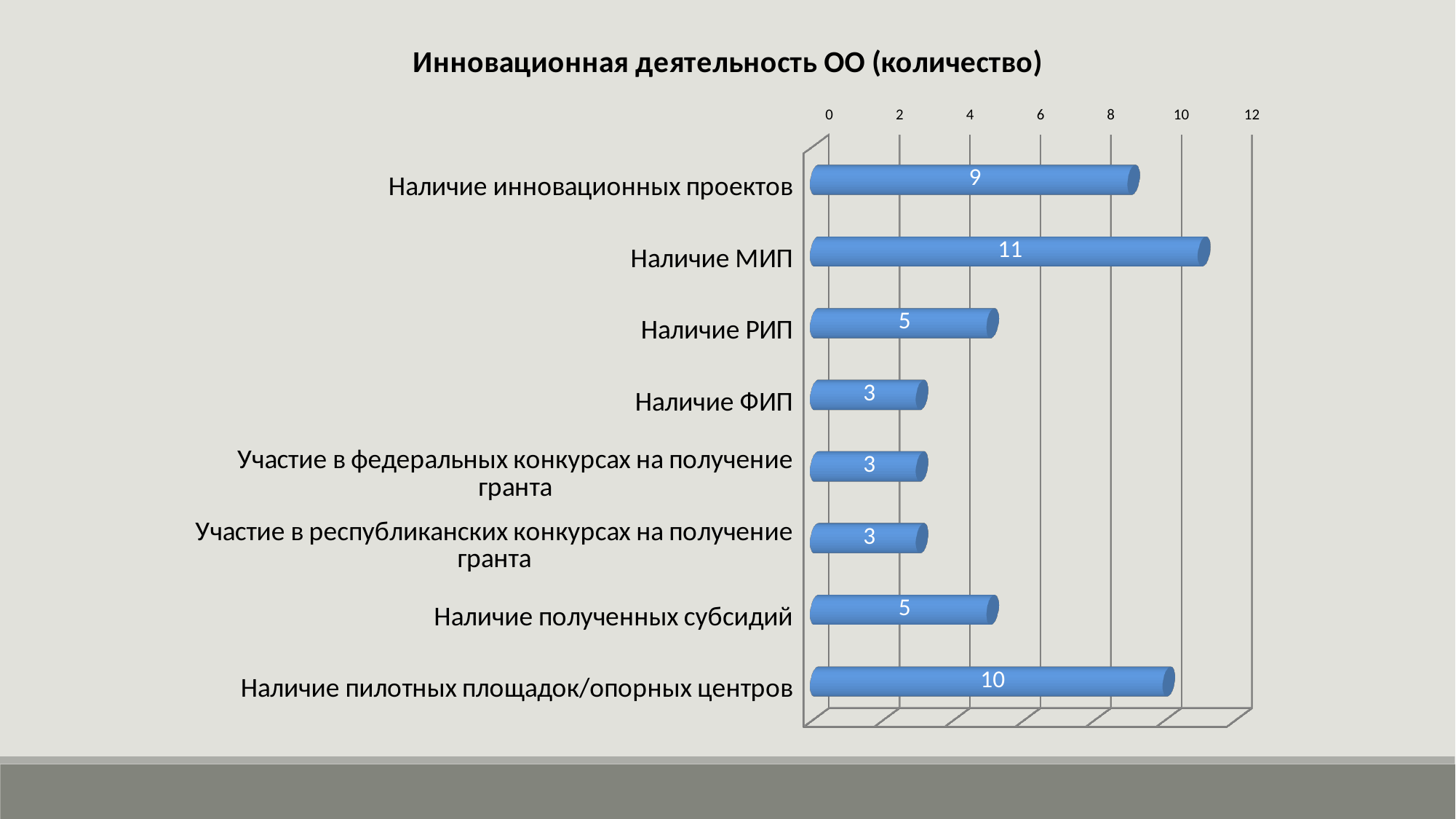
What is the value for Наличие МИП? 11 Is the value for Наличие полученных субсидий greater or less than 4? greater What is the value for Наличие пилотных площадок/опорных центров? 10 Which category has the highest value? Наличие МИП How many categories have a value of 3? 3 What is the title of the chart? Инновационная деятельность ОО (количество) What kind of chart is shown on the slide? bar chart What is the difference between the values for Наличие МИП and Наличие РИП? 6 What is the value for Наличие инновационных проектов? 9 How many categories are shown in the chart? 8 What is the value for Наличие ФИП? 3 Which is larger, the value for Наличие инновационных проектов or the value for Наличие пилотных площадок/опорных центров? Наличие пилотных площадок/опорных центров